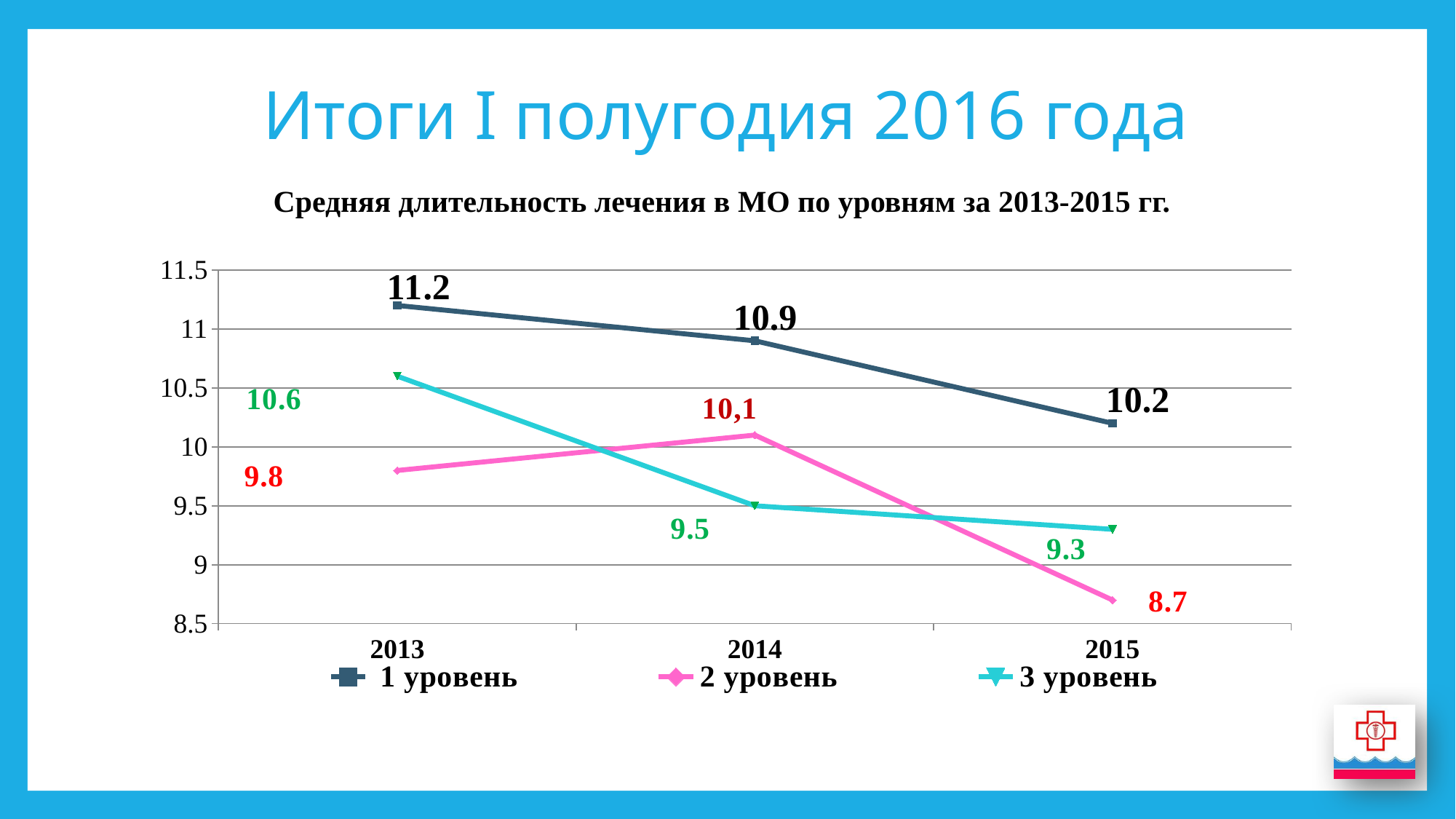
What type of chart is shown on the slide? line chart Which series has the highest value in 2013? 1 уровень How many series does the legend list? 3 What is the value for 1 уровень in 2015? 10.2 What is the value for 3 уровень in 2015? 9.3 How many years are plotted along the x axis? 3 What is the difference between the 1 уровень values in 2013 and 2015? 1 Which is larger in 2014: the value for 2 уровень or the value for 3 уровень? 2 уровень What is the value for 2 уровень in 2014? 10,1 Which series has the lowest value in 2015? 2 уровень Does the value for 1 уровень rise or fall from 2013 to 2015? fall What is the value for 1 уровень in 2013? 11.2